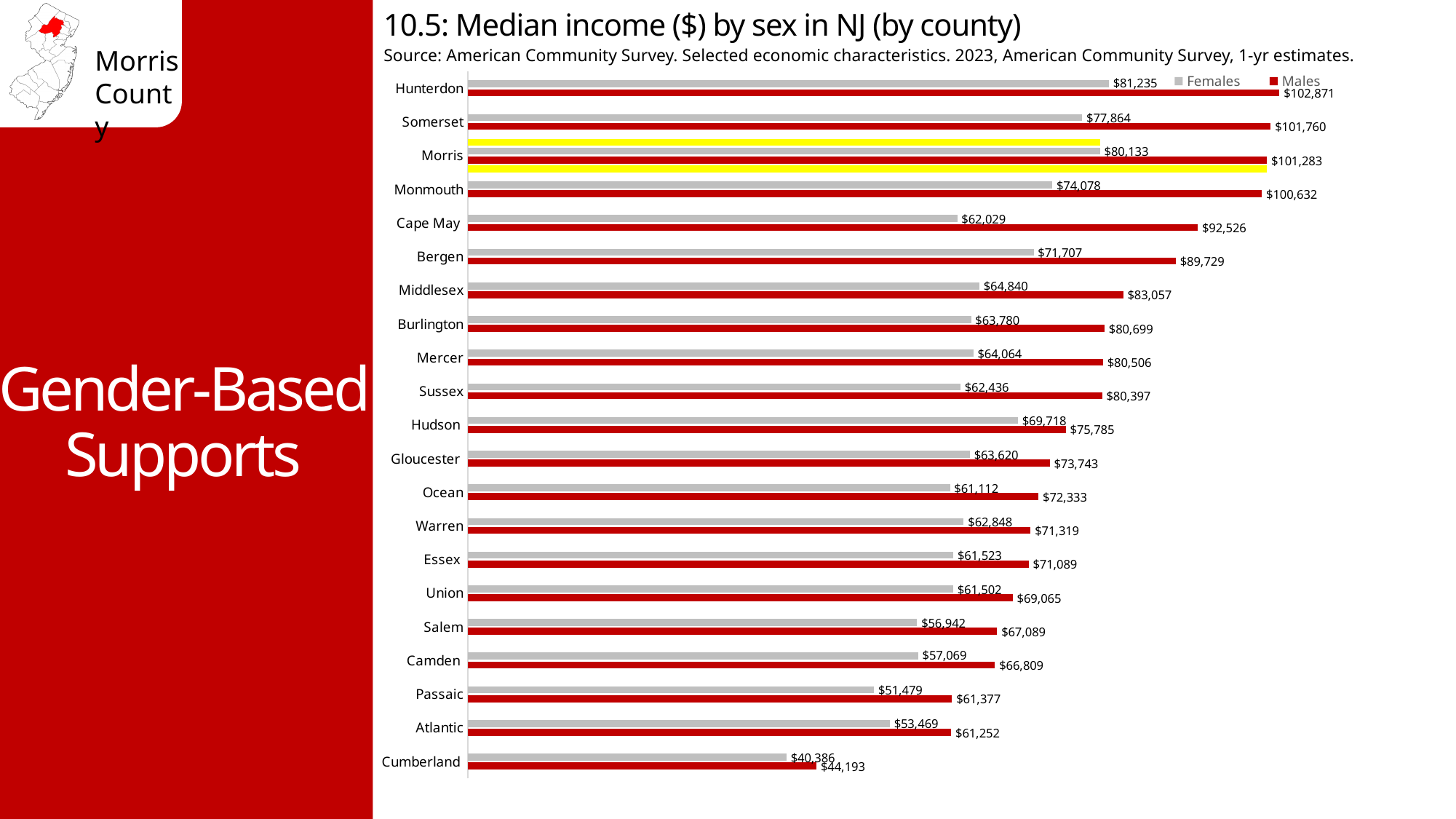
What type of chart is shown on the slide? Bar chart What is the median income for males in Morris County? $101,283 How many counties are shown in the chart? 21 How many series does the legend list? 2 Which county has the highest median income for males? Hunterdon What is the difference between male and female median income in Cumberland County? $3,807 What is the median income for females in Morris County? $80,133 Which county has the lowest median income for females? Cumberland What is the median income for males in Cumberland County? $44,193 What is the median income for females in Hunterdon County? $81,235 What is the difference between male and female median income in Morris County? $21,150 Which is larger, the female median income in Hudson County or the female median income in Bergen County? Bergen County